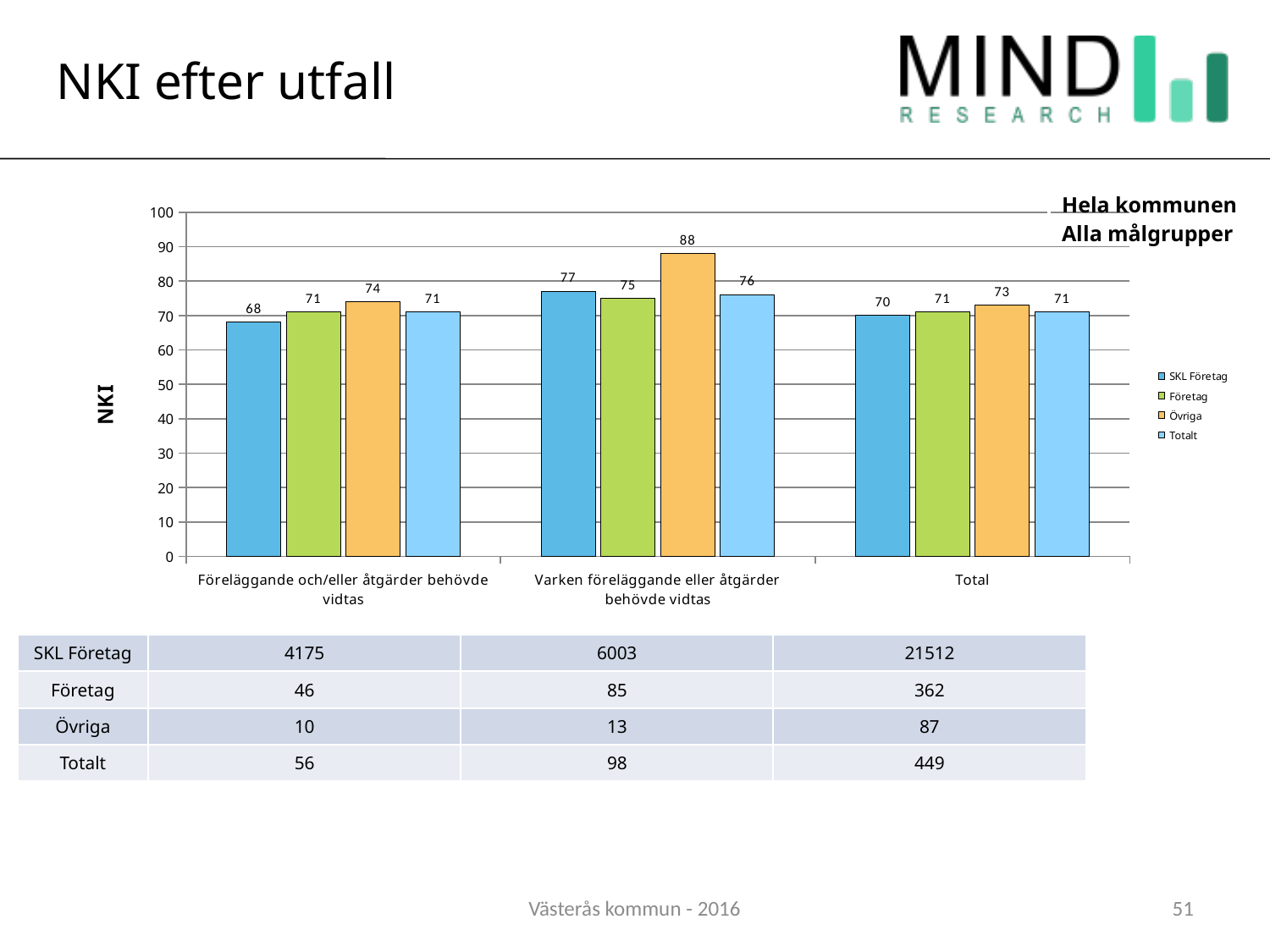
What is the NKI value for Företag in the category "Varken föreläggande eller åtgärder behövde vidtas"? 75 What is the difference between the Övriga value and the SKL Företag value in the category "Varken föreläggande eller åtgärder behövde vidtas"? 11 Is the Övriga value in the "Total" category greater or less than 80? less What is the NKI value for Övriga in the category "Varken föreläggande eller åtgärder behövde vidtas"? 88 Which is larger: the SKL Företag value for "Föreläggande och/eller åtgärder behövde vidtas" or the SKL Företag value for "Varken föreläggande eller åtgärder behövde vidtas"? Varken föreläggande eller åtgärder behövde vidtas What is the NKI value for Totalt in the "Total" category? 71 How many series does the chart legend list? 4 What is the NKI value for SKL Företag in the category "Föreläggande och/eller åtgärder behövde vidtas"? 68 How many categories are shown on the x axis of the chart? 3 What kind of chart is shown on the slide? bar chart Which series has the highest NKI value in the category "Varken föreläggande eller åtgärder behövde vidtas"? Övriga Which series has the lowest NKI value in the category "Föreläggande och/eller åtgärder behövde vidtas"? SKL Företag